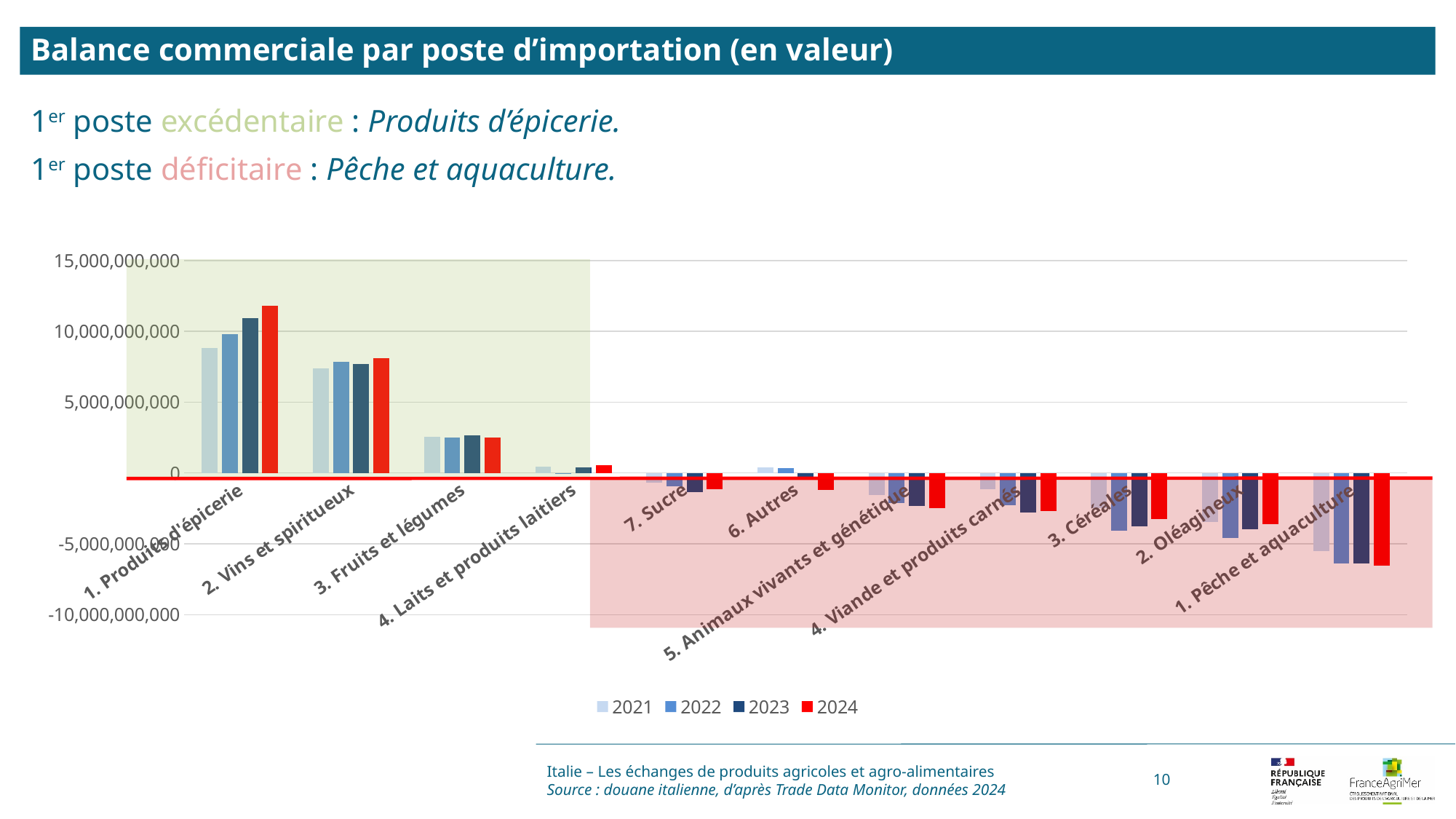
Which is larger in 2024: 1. Produits d'épicerie or 2. Vins et spiritueux? 1. Produits d'épicerie Is the 2024 value for 1. Pêche et aquaculture greater or less than -5,000,000,000? less Do the values for 1. Produits d'épicerie rise or fall from 2021 to 2024? rise How many series does the legend list? 4 How many categories are shown on the x axis of the chart? 11 Is the 2024 value for 3. Fruits et légumes greater or less than 5,000,000,000? less Is the 2024 value for 2. Vins et spiritueux greater or less than 5,000,000,000? greater What kind of chart is shown on the slide? bar chart Which category has the highest value in 2024? 1. Produits d'épicerie Which category has the lowest (most negative) value in 2024? 1. Pêche et aquaculture Which series is shown in red in the legend? 2024